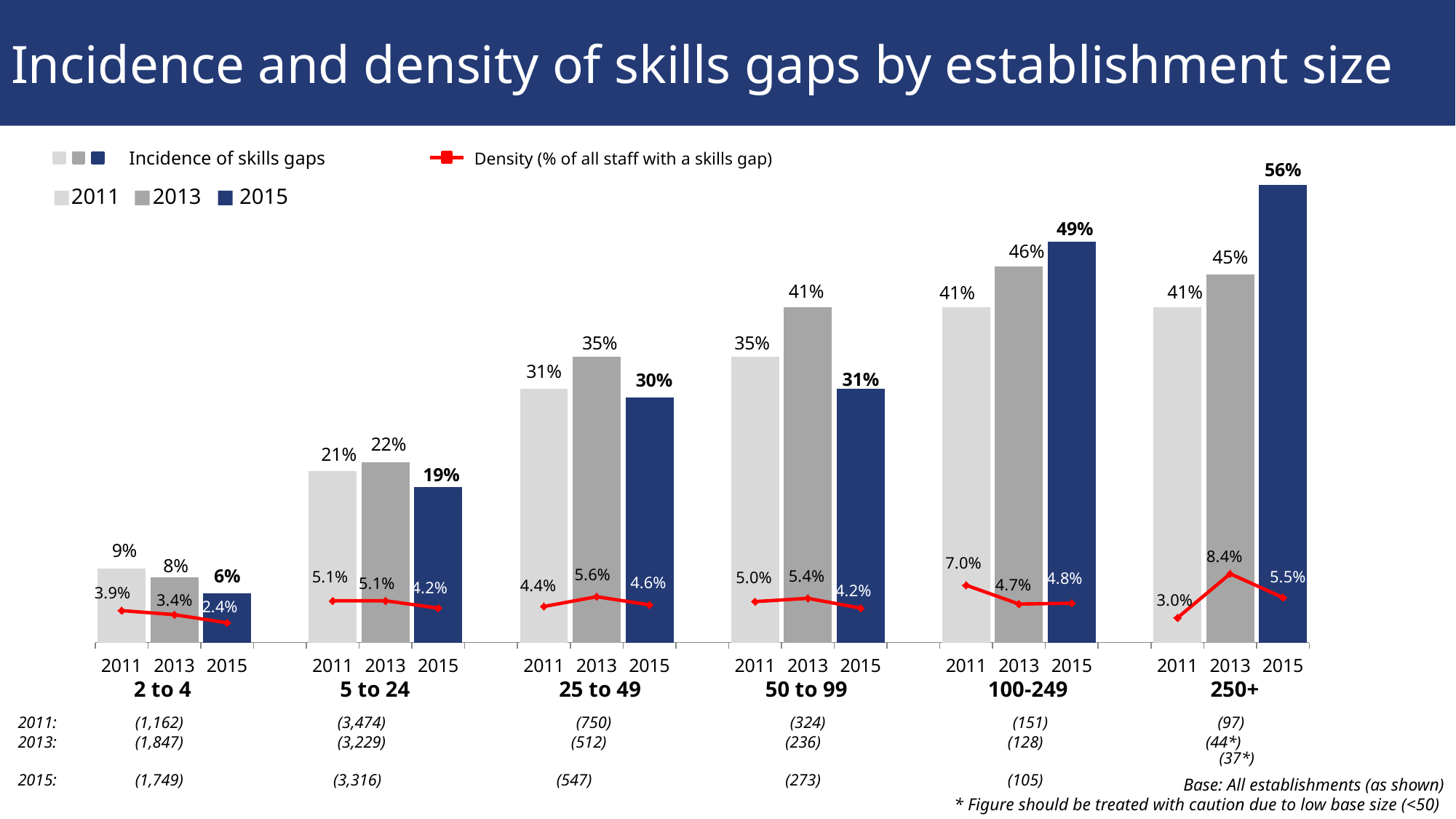
What is the incidence of skills gaps for establishments with 5 to 24 staff in 2013? 22% What is the density of skills gaps for establishments with 100-249 staff in 2011? 7.0% Which establishment size band has the lowest incidence of skills gaps in 2015? 2 to 4 What is the difference between the 2015 incidence of skills gaps for 250+ establishments and for 100-249 establishments? 7 percentage points What is the incidence of skills gaps for establishments with 250+ staff in 2015? 56% What colour is the line showing density of skills gaps? Red Which is larger: the 2013 incidence of skills gaps for 25 to 49 establishments or for 50 to 99 establishments? 50 to 99 How many establishment size bands are shown on the chart? 6 What kind of chart is used to show the incidence of skills gaps? Bar chart What is the density of skills gaps for establishments with 2 to 4 staff in 2011? 3.9% How many years does the legend list for incidence of skills gaps? 3 Which establishment size band has the highest incidence of skills gaps in 2015? 250+